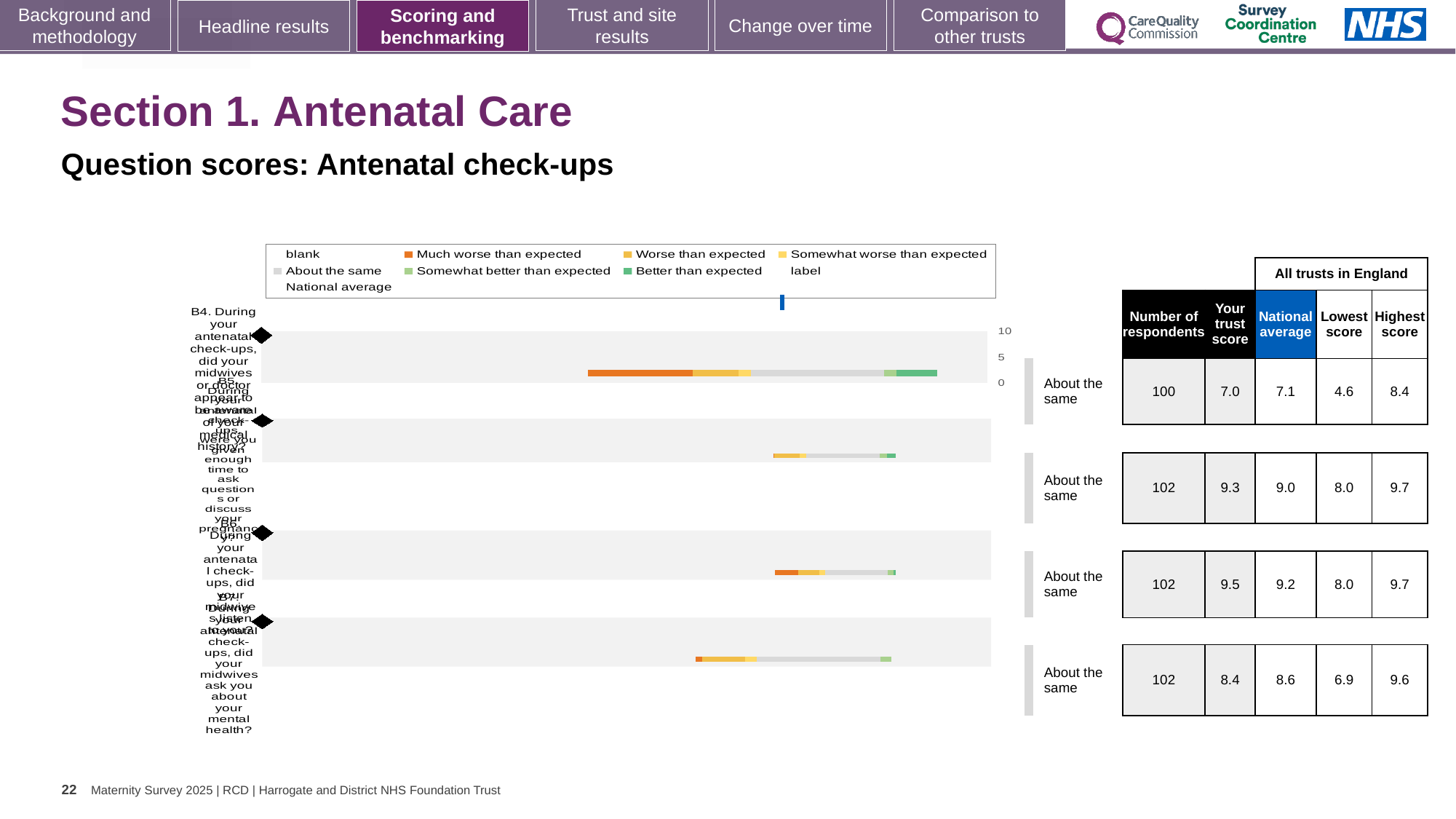
What kind of chart is shown on the slide? bar chart For the last row (B7), which is larger: 'Your trust score' or the 'National average'? National average In the table beside the chart, what is the number of respondents for the first row (B4)? 100 What is the highest value shown on the chart's x axis? 10 In the table beside the chart, what is the lowest 'National average' value? 7.1 In the table beside the chart, which row has the highest 'Your trust score', and what is it? Third row (B6), 9.5 In the table beside the chart, what is 'Your trust score' for the first row (B4)? 7.0 In the table beside the chart, what is the difference between the highest score and the lowest score for the first row (B4)? 3.8 What colour represents 'Much worse than expected' in the chart legend? orange What benchmark category is shown for every question row in the chart? About the same How many entries does the chart legend list? 9 How many question rows (bars) are plotted in the chart? 4